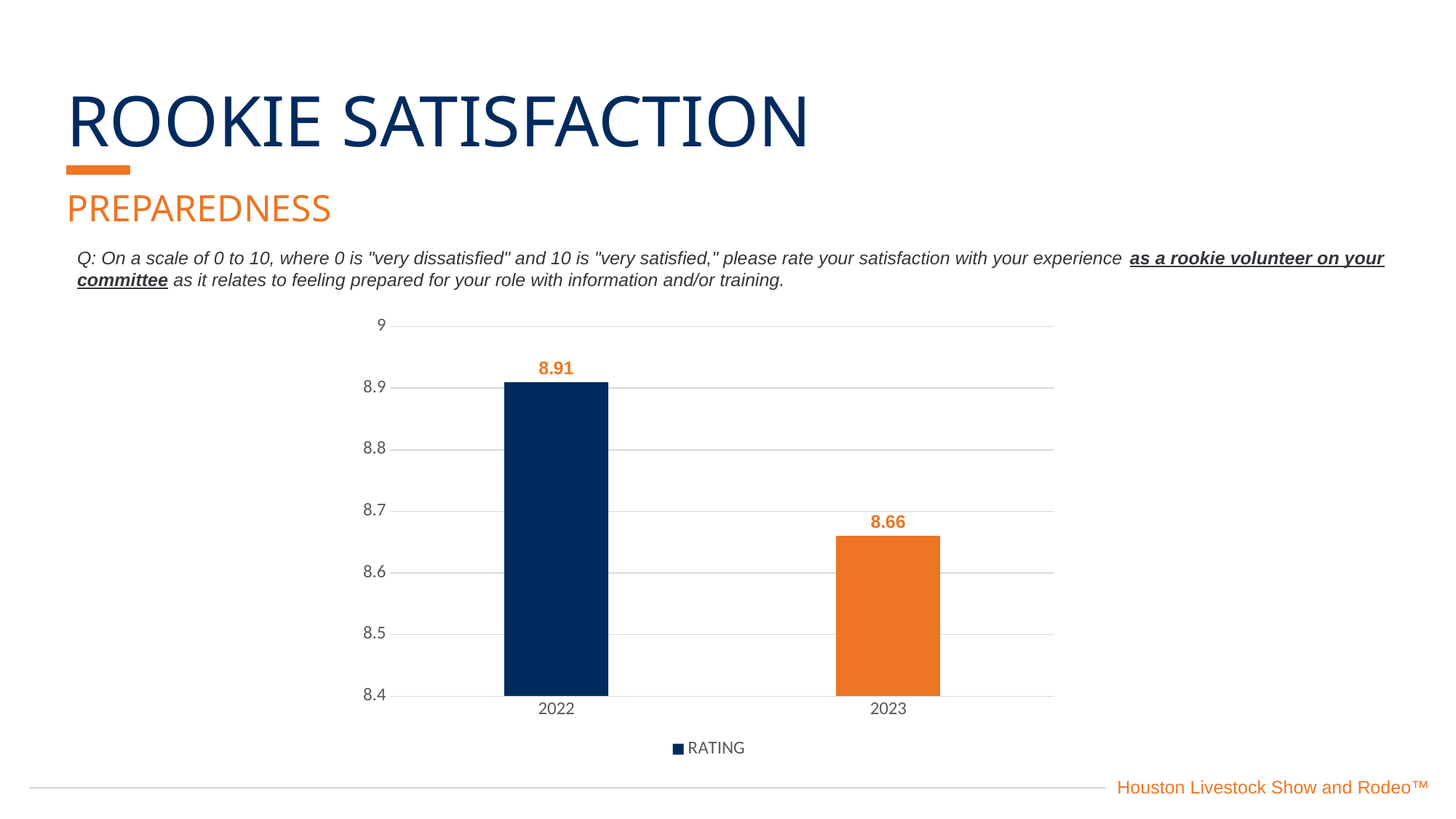
How many series does the legend list? 1 What is the rating for 2023? 8.66 Which year has the lowest rating? 2023 What is the rating for 2022? 8.91 Is the rating for 2022 greater or less than 8.8? greater What is the difference between the 2022 rating and the 2023 rating? 0.25 Is the rating for 2023 greater or less than 8.7? less How many years are shown on the chart? 2 What kind of chart is shown on the slide? bar chart Does the rating rise or fall from 2022 to 2023? fall Which is larger, the rating for 2022 or the rating for 2023? 2022 Which year has the highest rating? 2022